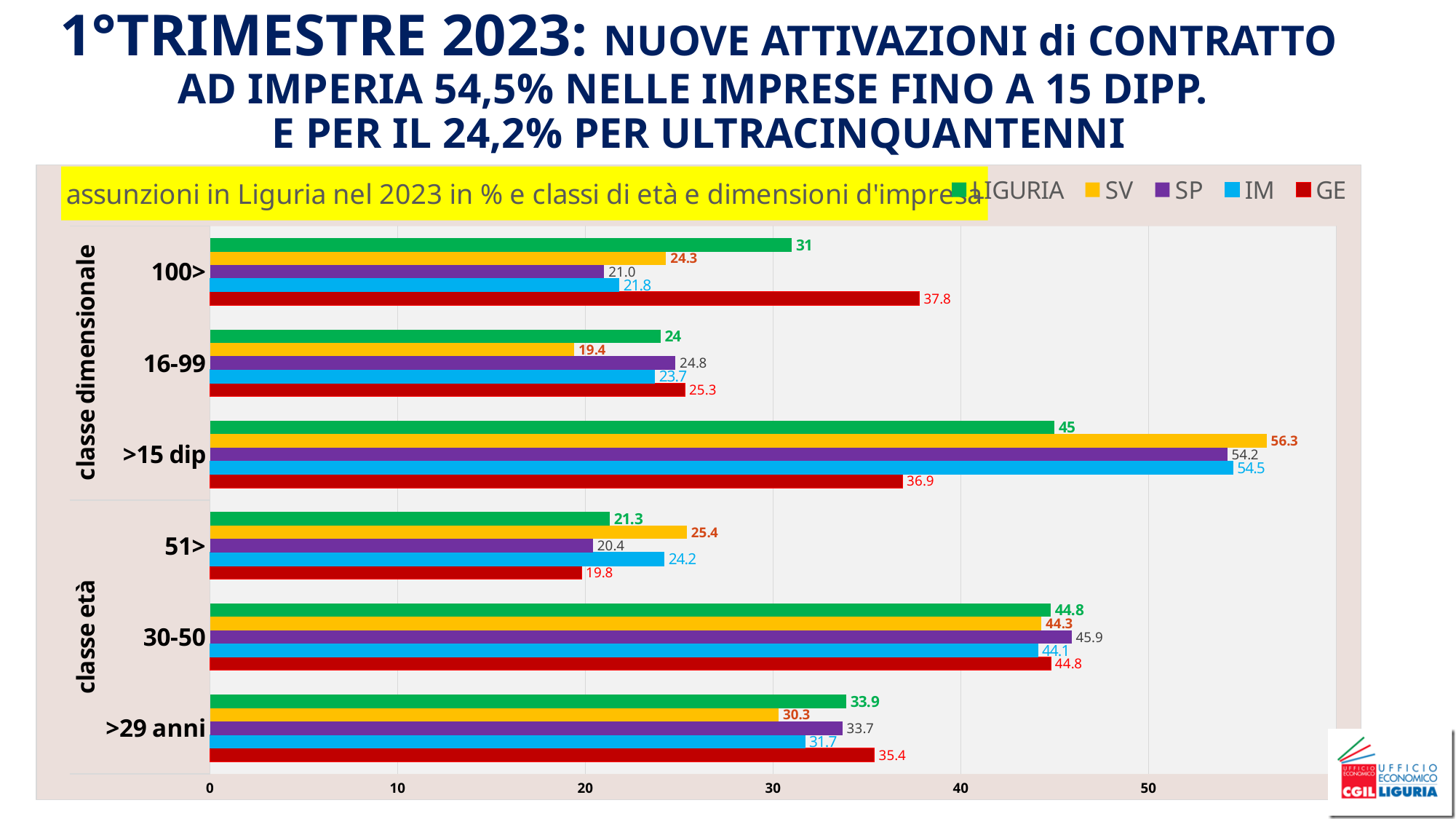
How many series does the legend list? 5 Which series is shown in yellow in the legend? SV What is the value for LIGURIA in the >29 anni category? 33.9 What type of chart is shown on the slide? bar chart What is the difference between the SV and GE values in the >15 dip category? 19.4 What is the value for GE in the 100> category? 37.8 Which is larger in the 100> category, the value for LIGURIA or the value for GE? GE What is the value for SV in the 51> category? 25.4 Which series has the lowest value in the 51> category? GE How many categories are shown on the vertical axis of the chart? 6 Which series has the highest value in the >15 dip category? SV What is the value for IM in the >15 dip category? 54.5